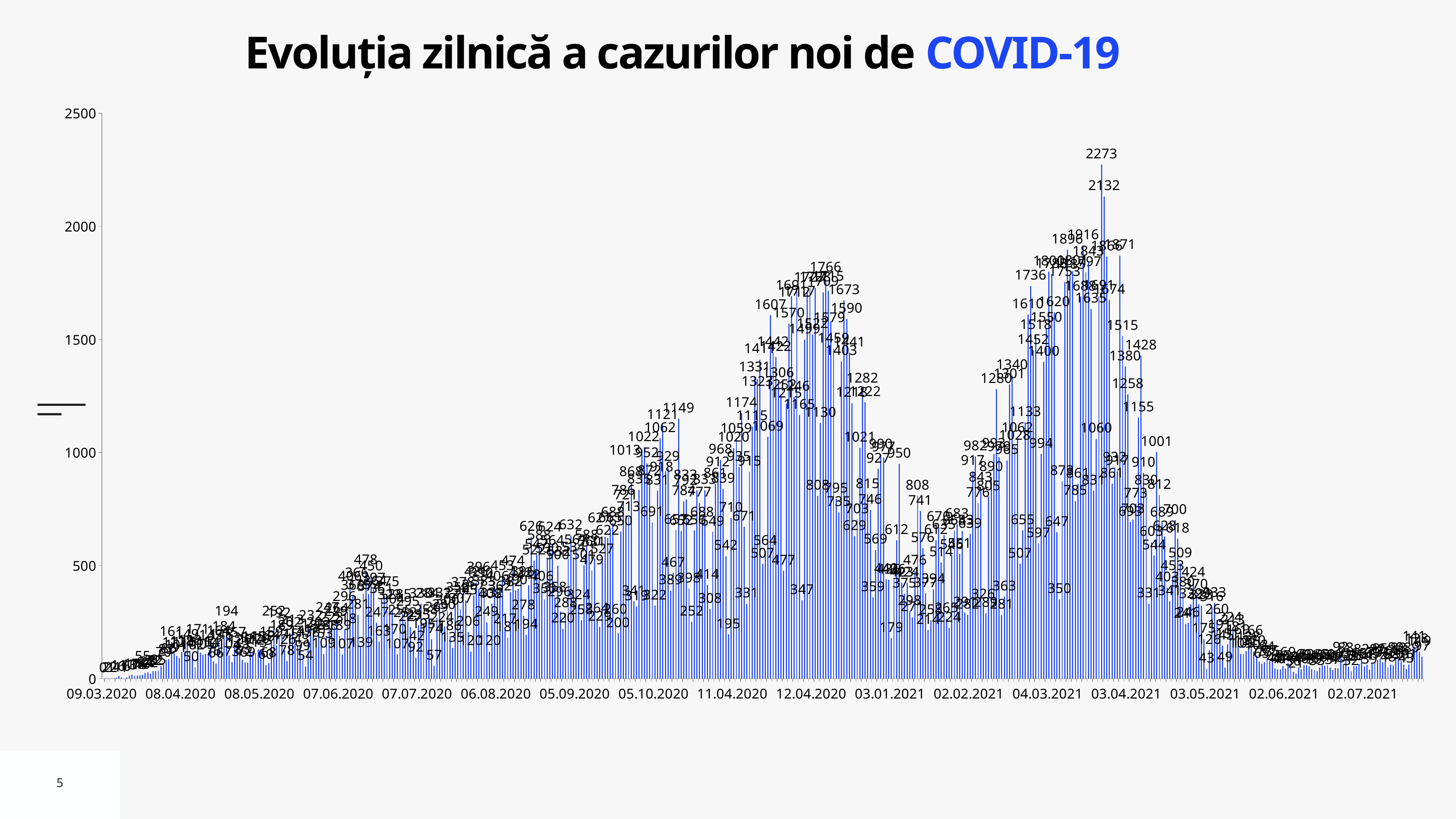
What is the highest tick value shown on the vertical axis? 2500 What is the second-highest daily value labelled on the chart, next to the 2273 peak? 2132 What is the first date label on the horizontal axis? 09.03.2020 What is the title of the chart? Evoluția zilnică a cazurilor noi de COVID-19 What is the highest daily value labelled on the chart? 2273 What kind of chart is shown on the slide? bar chart Do the values rise or fall between 09.03.2020 and 08.04.2020? rise Is the highest bar on the chart greater or less than 2000? greater What is the difference between the two highest labelled values, 2273 and 2132? 141 Which peak is higher: the one near 12.04.2020 (labelled 1766) or the one near 03.04.2021 (labelled 2273)? the one near 03.04.2021 Are the bars around 02.06.2021 greater or less than 500? less Do the values rise or fall between 03.04.2021 and 02.06.2021? fall